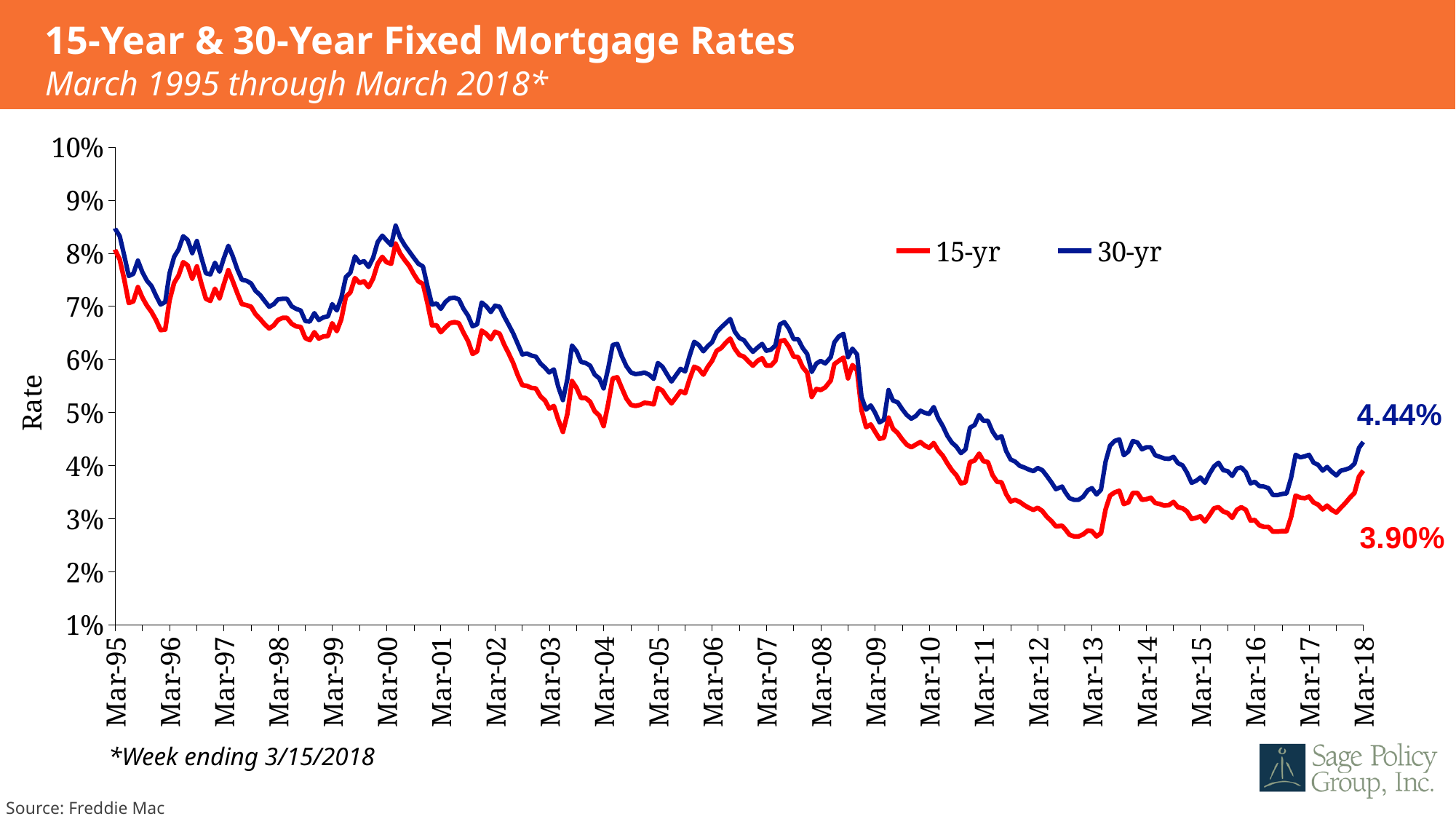
Is the 30-yr rate at Mar-09 greater or less than 6%? less What kind of chart is shown on the slide? line chart What is the 15-yr fixed mortgage rate at the end of the series (March 2018)? 3.90% What is the difference between the 30-yr and 15-yr rates at the end of the series (March 2018)? 0.54% What colour is the line for the 15-yr series? red What is the 30-yr fixed mortgage rate at the end of the series (March 2018)? 4.44% Is the 15-yr rate at Mar-13 greater or less than 3%? less Which series has the higher rate at the end of the series (March 2018), 15-yr or 30-yr? 30-yr How many series does the legend list? 2 Is the 30-yr rate at Mar-95 greater or less than 8%? greater What is the title of the chart? 15-Year & 30-Year Fixed Mortgage Rates Overall, do mortgage rates rise or fall from March 1995 to March 2018? fall